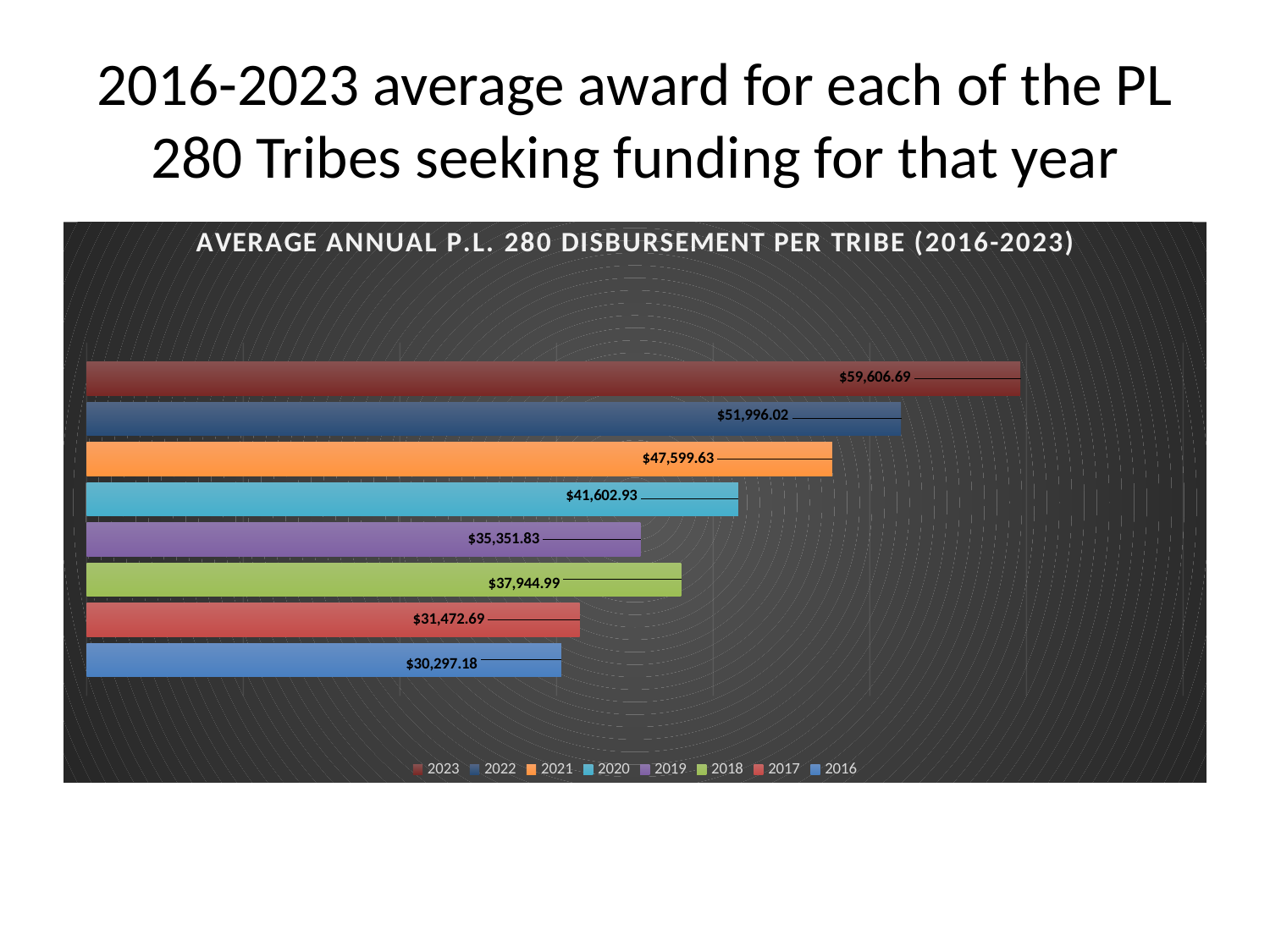
What is the difference between the 2018 and 2019 values? $2,593.16 What is the value shown for 2018? $37,944.99 Which year has the highest average disbursement per tribe? 2023 Which year has the lowest average disbursement per tribe? 2016 What is the difference between the 2023 and 2022 values? $7,610.67 What kind of chart is shown on the slide? Bar chart Which is larger, the value for 2019 or the value for 2018? 2018 What is the average annual P.L. 280 disbursement per tribe for 2016? $30,297.18 What is the value shown for 2020? $41,602.93 How many years does the legend list? 8 What is the average annual P.L. 280 disbursement per tribe for 2023? $59,606.69 What is the title of the chart? Average Annual P.L. 280 Disbursement Per Tribe (2016-2023)